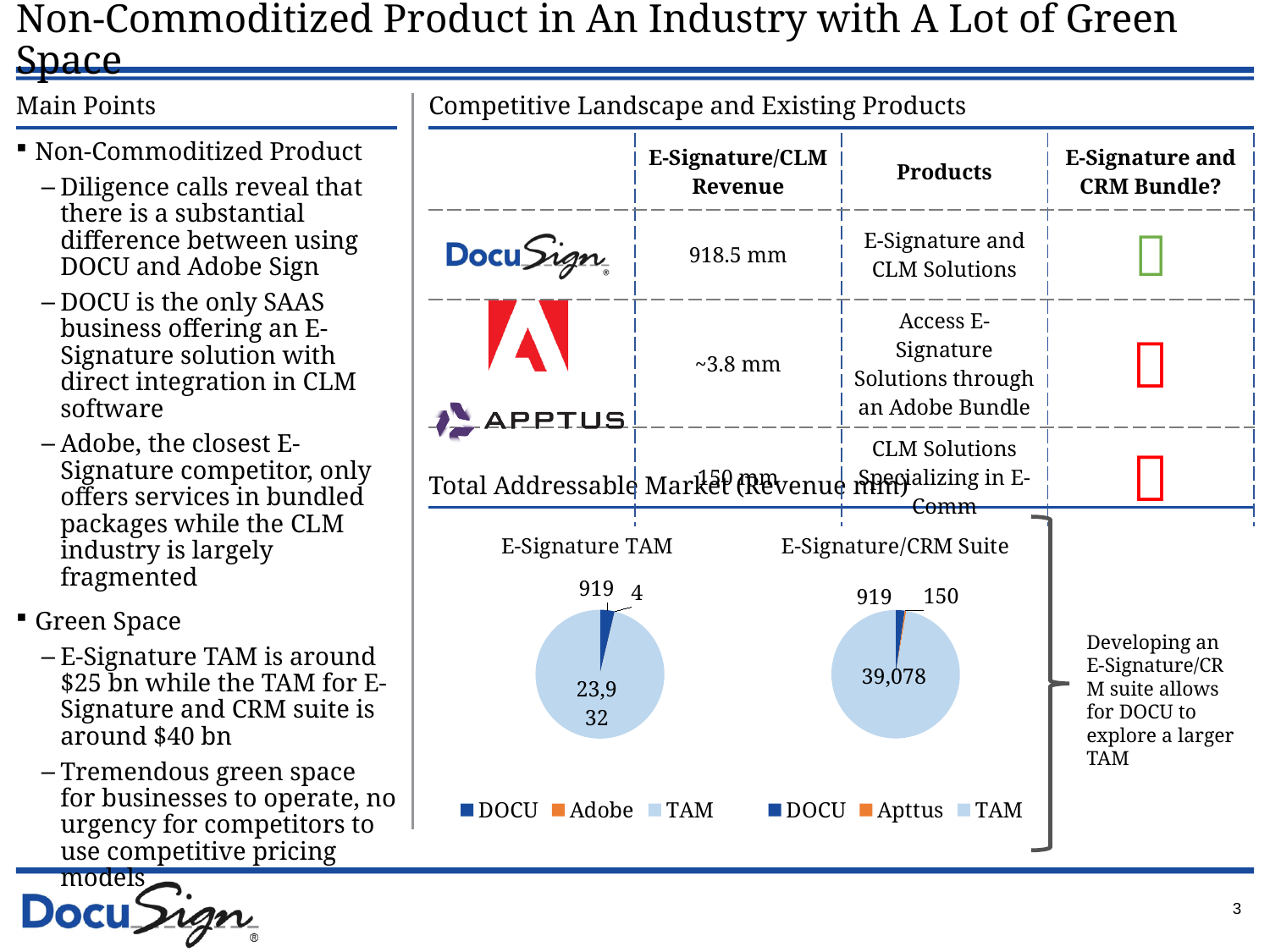
How many series does the legend of the E-Signature TAM chart list? 3 In the E-Signature/CRM Suite pie chart, what is the value for TAM? 39,078 In the E-Signature/CRM Suite pie chart, what is the value for Apttus? 150 In the E-Signature TAM pie chart, which is larger, DOCU or Adobe? DOCU In the E-Signature TAM pie chart, what is the value for Adobe? 4 What is the difference between the DOCU value and the Apttus value in the E-Signature/CRM Suite pie chart? 769 What type of chart is the E-Signature TAM chart? Pie chart In the E-Signature/CRM Suite pie chart, which category has the smallest slice? Apttus What are the legend entries of the E-Signature/CRM Suite pie chart? DOCU, Apttus, TAM How many slices does the E-Signature/CRM Suite pie chart have? 3 In the E-Signature TAM pie chart, what is the value for DOCU? 919 In the E-Signature TAM pie chart, which category has the largest slice? TAM